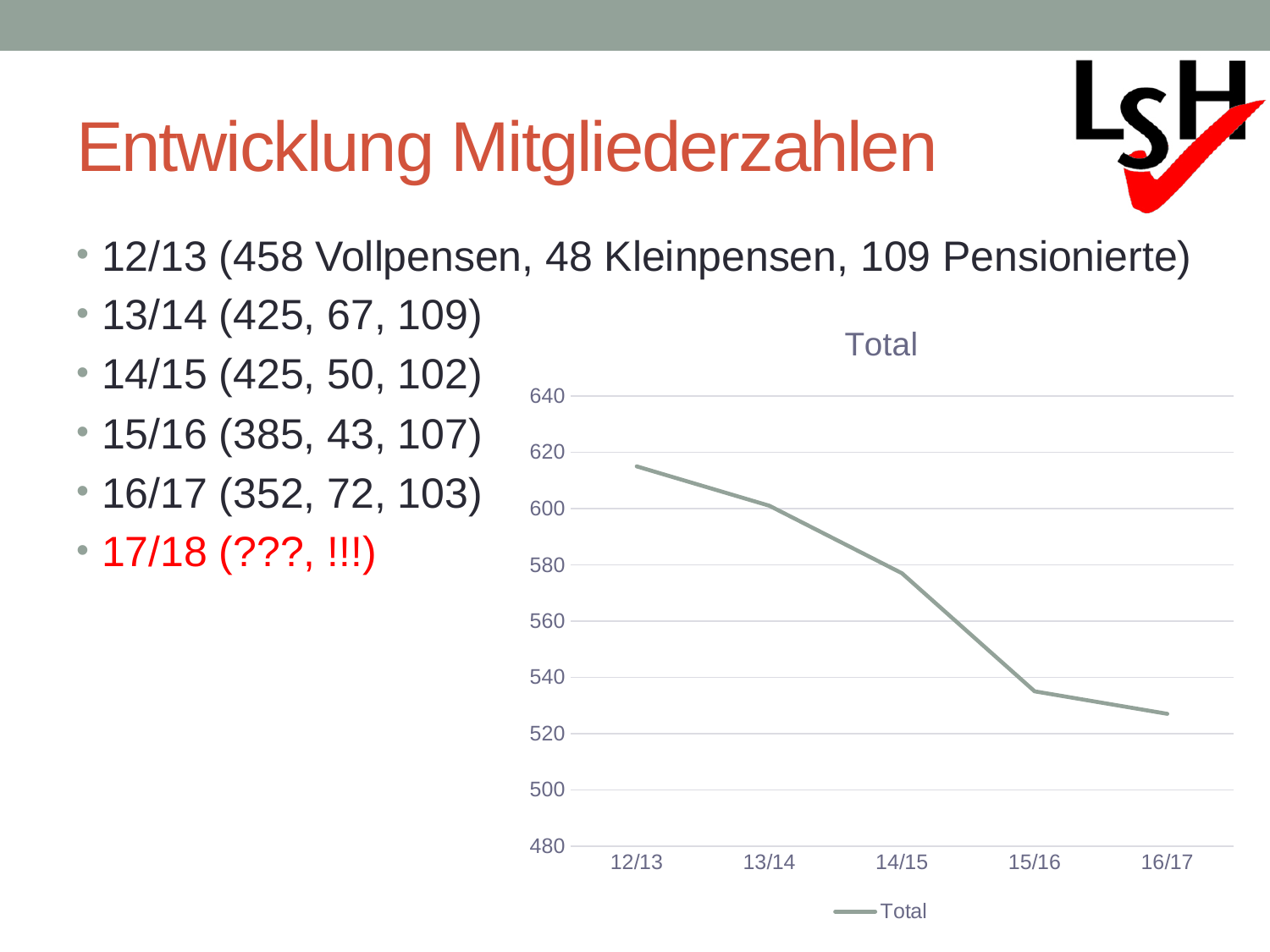
Is the Total value for 12/13 greater or less than 620? less Which has the larger Total value, 12/13 or 15/16? 12/13 Do the Total values rise or fall from 12/13 to 16/17? fall How many series does the chart legend list? 1 Is the Total value for 15/16 greater or less than 540? less Which year has the lowest Total value in the chart? 16/17 Is the Total value for 12/13 greater or less than 600? greater Which year has the highest Total value in the chart? 12/13 How many points are plotted along the x axis of the chart? 5 What is the title of the chart? Total What kind of chart is shown on the slide? line chart